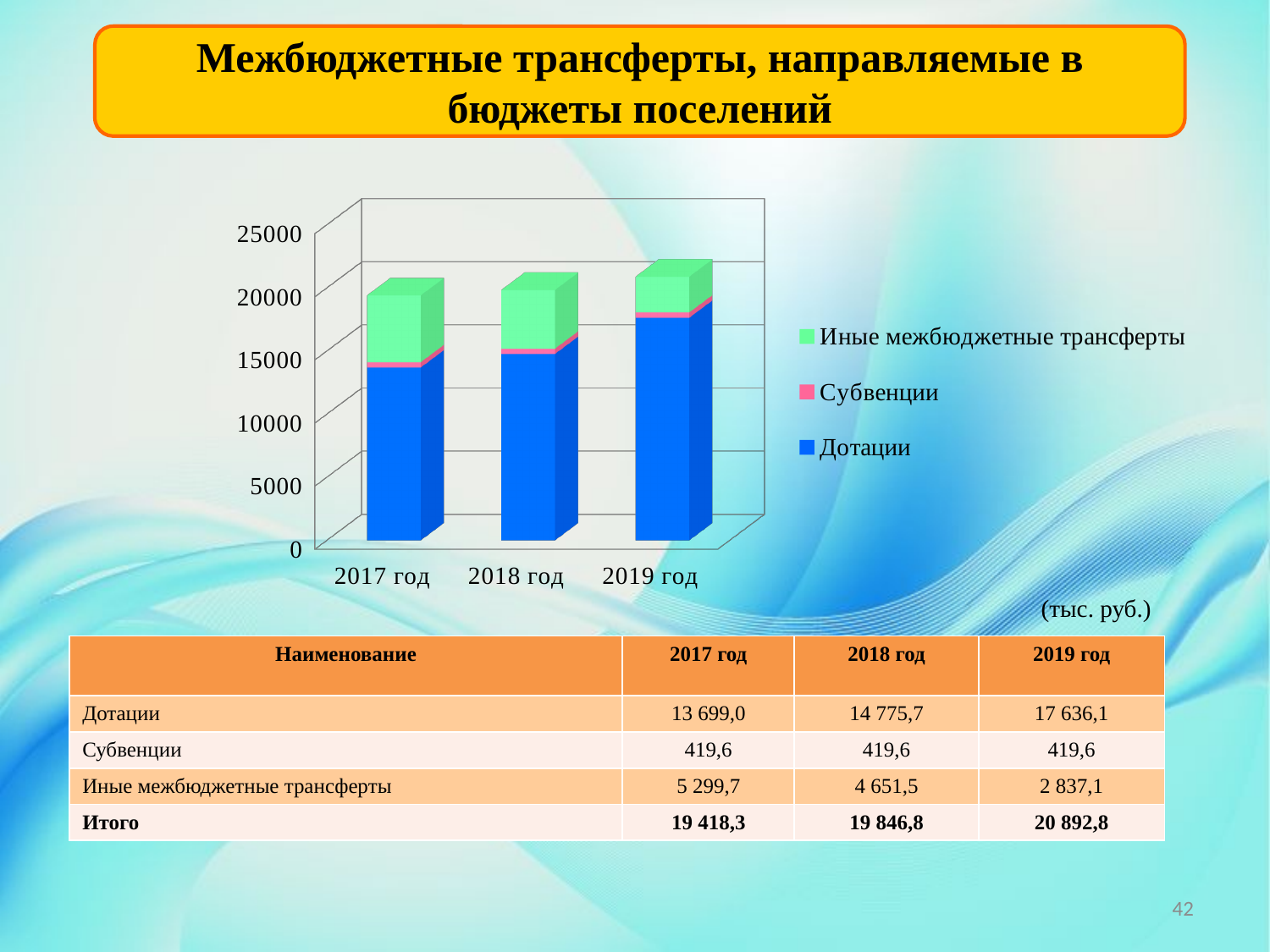
How many series does the chart legend list? 3 What is the value of Субвенции for 2018 год? 419,6 Is the Дотации value for 2017 год greater or less than 15000? less Which year has the lowest value for Иные межбюджетные трансферты? 2019 год What is the value of Иные межбюджетные трансферты for 2017 год? 5 299,7 What is the total of the stacked bar for 2018 год? 19 846,8 What is the value of Дотации for 2019 год? 17 636,1 Which series is shown in blue in the chart legend? Дотации What kind of chart is shown on the slide? stacked bar chart Which year has the highest total (Итого) of transfers? 2019 год Does the Дотации series rise or fall from 2017 год to 2019 год? rise How many years (categories) are shown on the x axis of the chart? 3